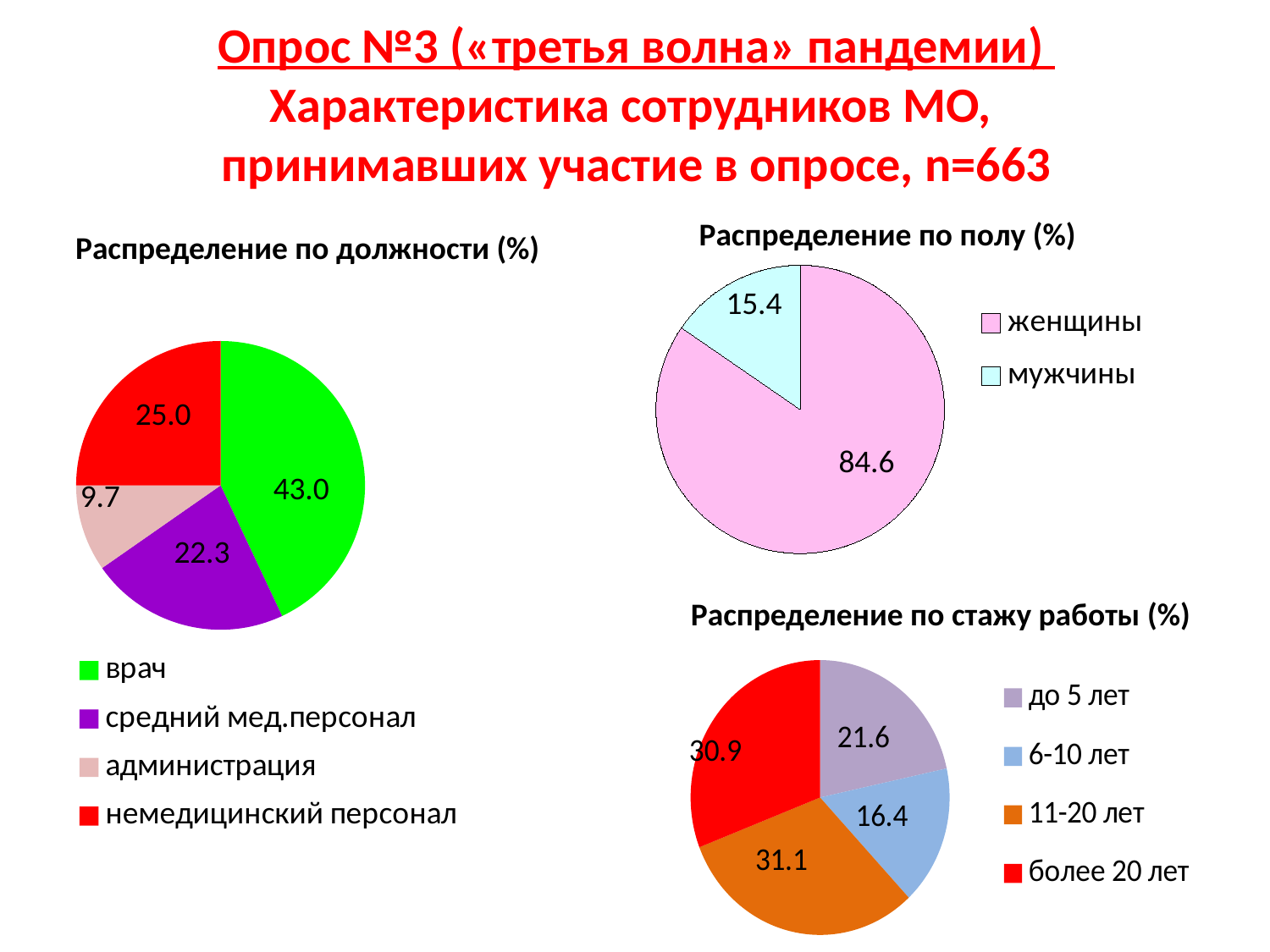
In the chart 'Распределение по должности (%)', which category has the smallest share? администрация In the chart 'Распределение по стажу работы (%)', which category has the smallest share? 6-10 лет How many entries does the legend of the chart 'Распределение по стажу работы (%)' list? 4 In the chart 'Распределение по должности (%)', what is the value for врач? 43.0 What kind of chart is 'Распределение по полу (%)'? pie chart In the chart 'Распределение по полу (%)', which is larger, женщины or мужчины? женщины In the chart 'Распределение по должности (%)', which category has the largest share? врач In the chart 'Распределение по стажу работы (%)', what is the difference between до 5 лет and 6-10 лет? 5.2 In the chart 'Распределение по стажу работы (%)', what is the value for 11-20 лет? 31.1 In the chart 'Распределение по полу (%)', what is the value for мужчины? 15.4 In the chart 'Распределение по должности (%)', what is the difference between немедицинский персонал and средний мед.персонал? 2.7 How many categories does the chart 'Распределение по должности (%)' show? 4